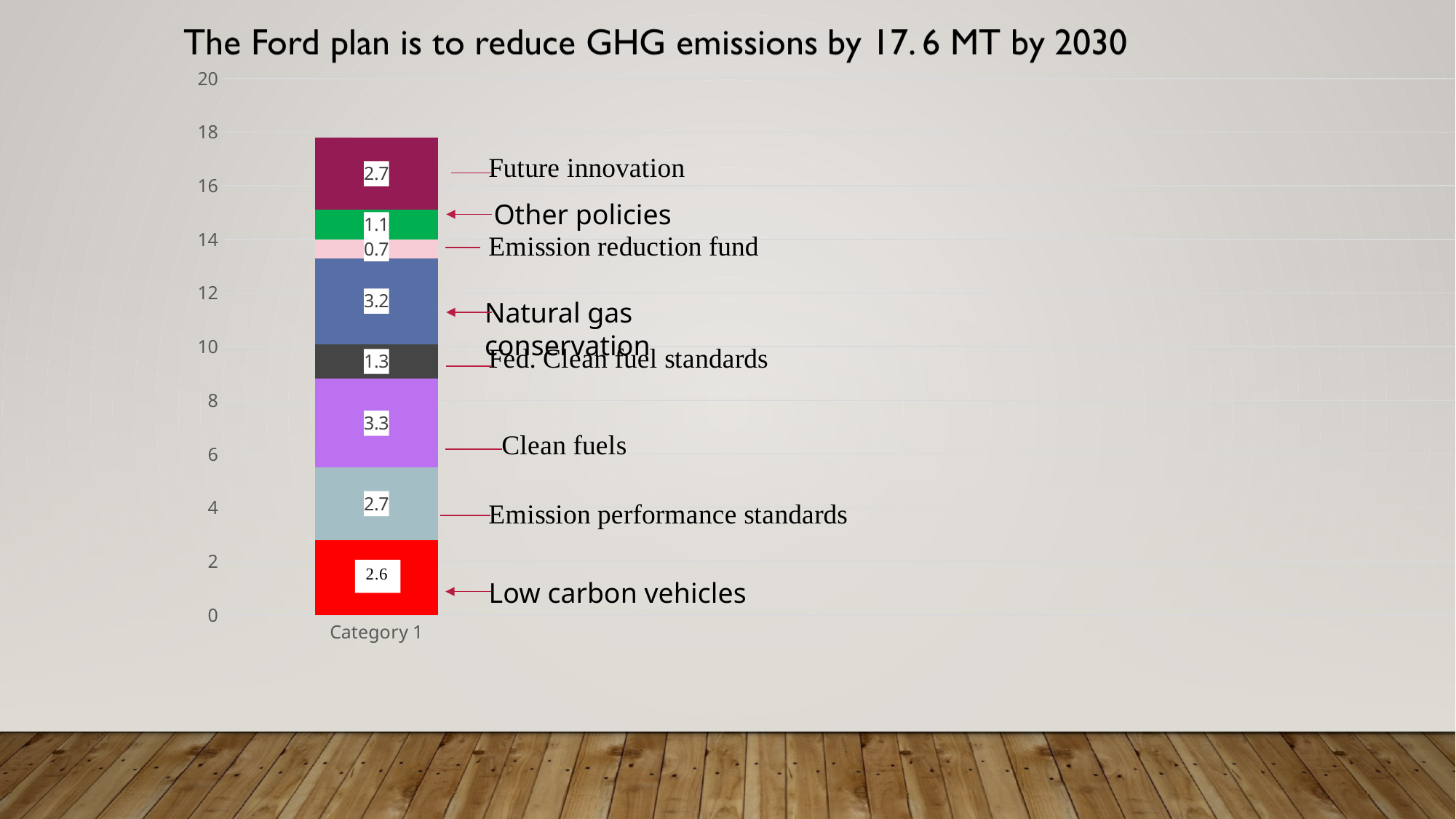
What is the value of the Low carbon vehicles segment? 2.6 How many segments make up the stacked bar? 8 What is the value of the Clean fuels segment? 3.3 What is the title of the slide? The Ford plan is to reduce GHG emissions by 17.6 MT by 2030 What type of chart is shown on the slide? Stacked bar chart What is the total of all segments in the stacked bar? 17.6 What is the value of the Natural gas conservation segment? 3.2 Which segment of the stacked bar has the smallest value? Emission reduction fund What is the difference between the Clean fuels value and the Fed. Clean fuel standards value? 2 Which is larger, the Other policies segment or the Emission reduction fund segment? Other policies What is the value of the Emission reduction fund segment? 0.7 Which segment of the stacked bar has the largest value? Clean fuels